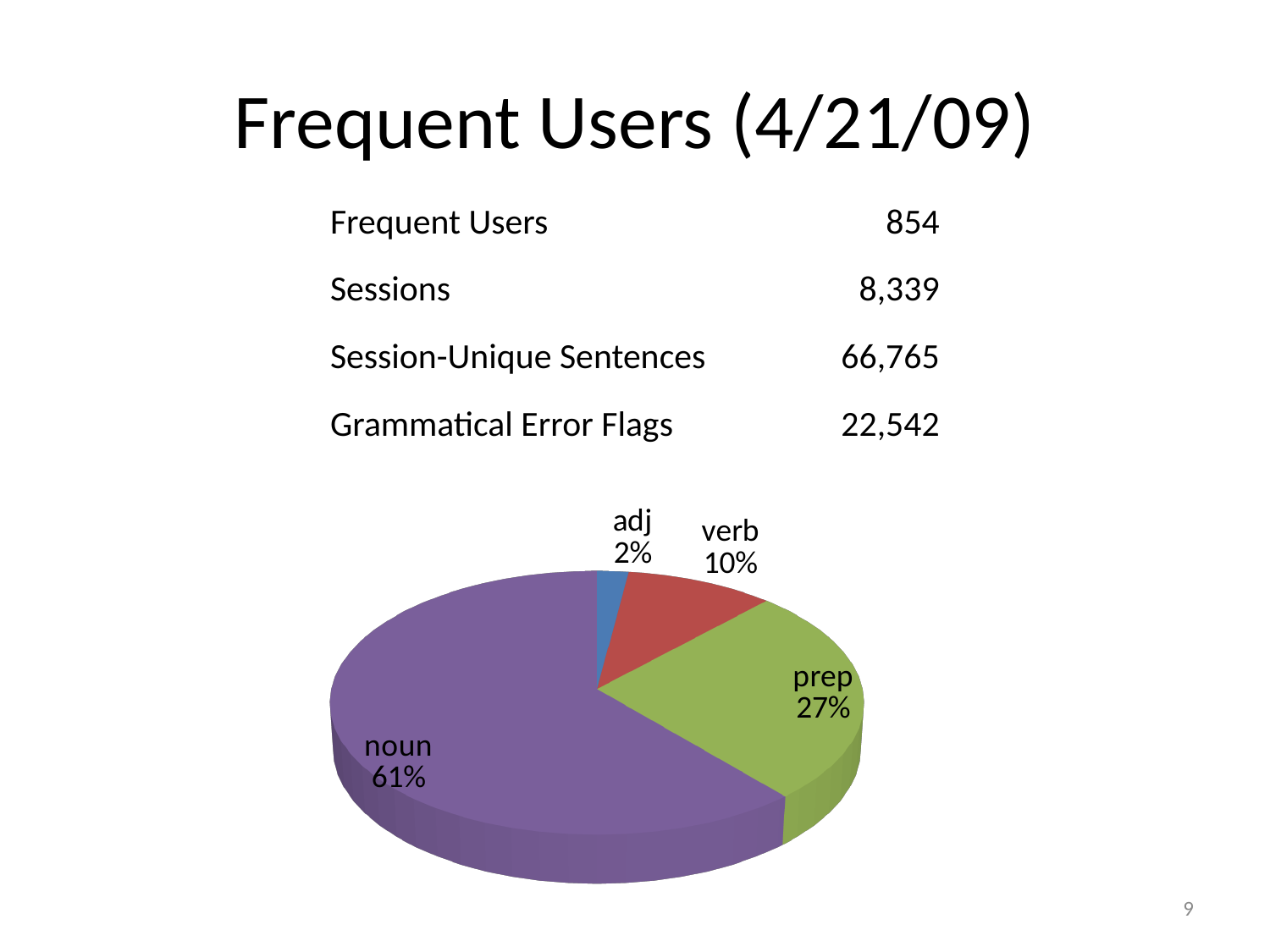
How many slices does the pie chart have? 4 What share of the pie does the noun slice represent? 61% Which slice of the pie chart is the largest? noun What is the difference in percentage points between the noun slice and the prep slice? 34 What kind of chart is shown on the slide? pie chart What share of the pie does the verb slice represent? 10% What is the difference in percentage points between the verb slice and the adj slice? 8 Which slice of the pie chart is the smallest? adj Which is larger in the pie chart, prep or verb? prep What share of the pie does the prep slice represent? 27% What colour is the noun slice in the pie chart? purple